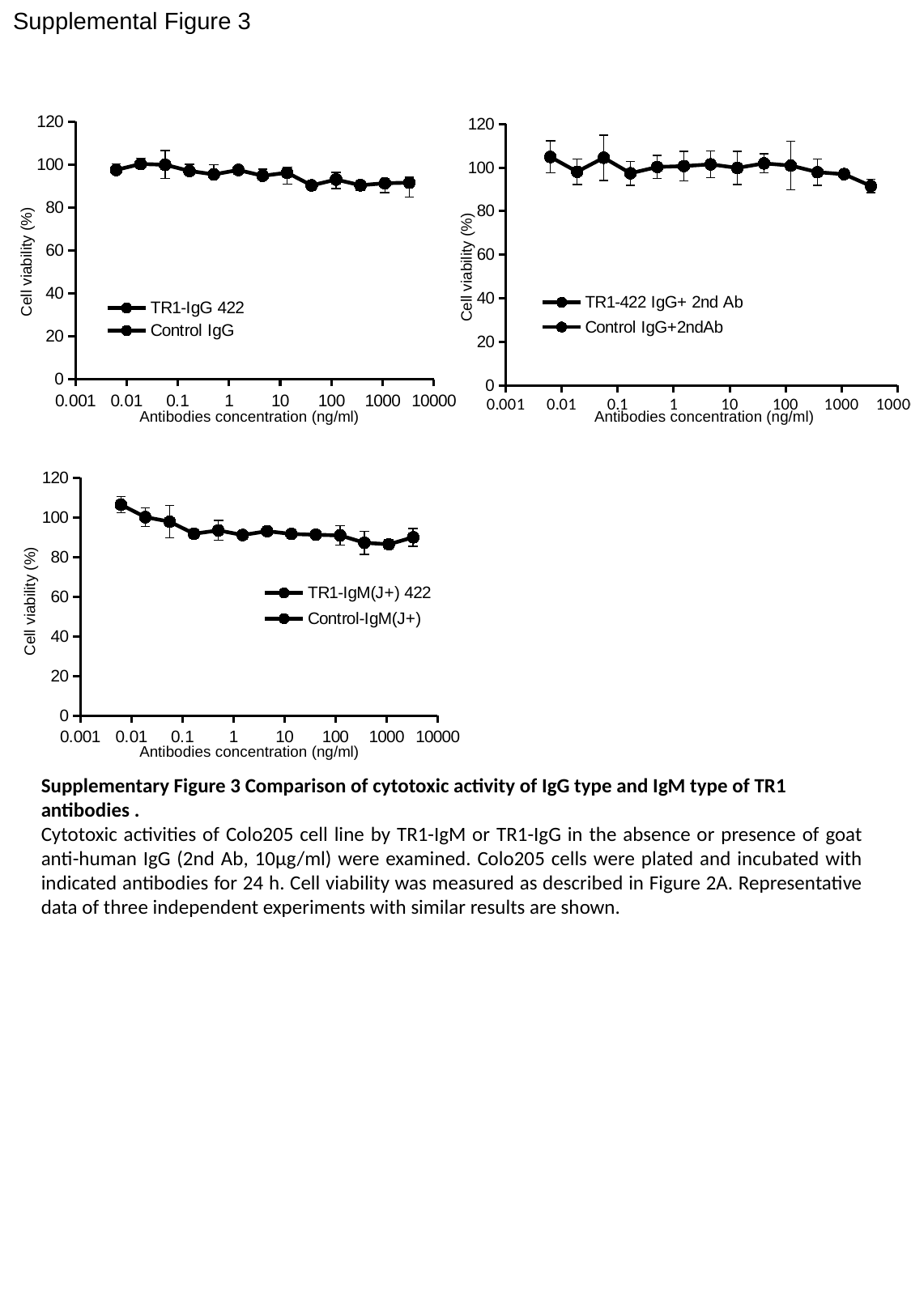
What is the y-axis label of the top-left chart? Cell viability (%) How many series does the legend of the top-right chart (TR1-422 IgG+ 2nd Ab) list? 2 In the top-right chart (TR1-422 IgG+ 2nd Ab), is the cell viability at the highest antibody concentration greater or less than 100? less In the top-left chart (TR1-IgG 422), are all plotted cell viability values greater or less than 80? greater In the top-left chart (TR1-IgG 422), does cell viability generally rise or fall as antibody concentration increases? fall What kind of chart is the top-left chart (TR1-IgG 422 / Control IgG)? Line chart In the bottom-left chart (TR1-IgM(J+) 422), does cell viability generally rise or fall as antibody concentration increases? fall How many series does the legend of the bottom-left chart (TR1-IgM(J+) 422) list? 2 In the bottom-left chart (TR1-IgM(J+) 422), is the cell viability at the lowest antibody concentration greater or less than 100? greater What are the two legend entries in the top-right chart? TR1-422 IgG+ 2nd Ab and Control IgG+2ndAb How many data points are plotted in the bottom-left chart (TR1-IgM(J+) 422)? 13